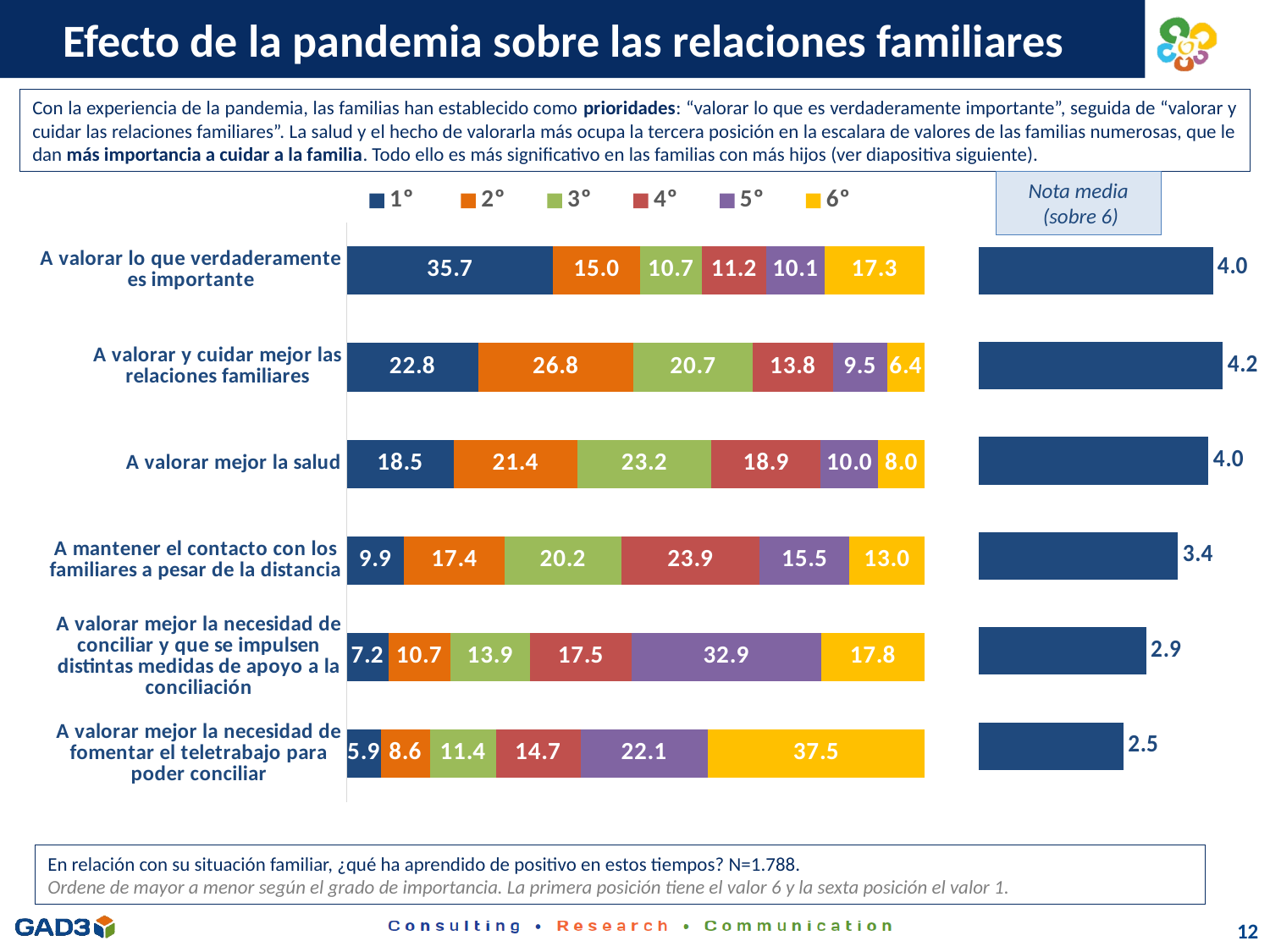
How many series does the legend of the stacked bar chart list? 6 In the "Nota media (sobre 6)" chart, what is the difference between the values for "A valorar y cuidar mejor las relaciones familiares" and "A mantener el contacto con los familiares a pesar de la distancia"? 0.8 In the "Nota media (sobre 6)" chart, which category has the lowest value? A valorar mejor la necesidad de fomentar el teletrabajo para poder conciliar How many categories are shown in the stacked bar chart? 6 In the stacked bar chart, which is larger for "A valorar mejor la salud": the 2° value or the 3° value? 3° In the stacked bar chart, what is the value of the 1° series for "A valorar lo que verdaderamente es importante"? 35.7 In the "Nota media (sobre 6)" chart, what is the value for "A valorar y cuidar mejor las relaciones familiares"? 4.2 What kind of chart is the chart on the left of the slide? Stacked bar chart In the "Nota media (sobre 6)" chart, which category has the highest value? A valorar y cuidar mejor las relaciones familiares In the stacked bar chart, what is the difference between the 1° value and the 2° value for "A valorar lo que verdaderamente es importante"? 20.7 In the stacked bar chart, what is the value of the 5° series for "A valorar mejor la necesidad de conciliar y que se impulsen distintas medidas de apoyo a la conciliación"? 32.9 In the stacked bar chart, what is the value of the 6° series for "A valorar mejor la necesidad de fomentar el teletrabajo para poder conciliar"? 37.5